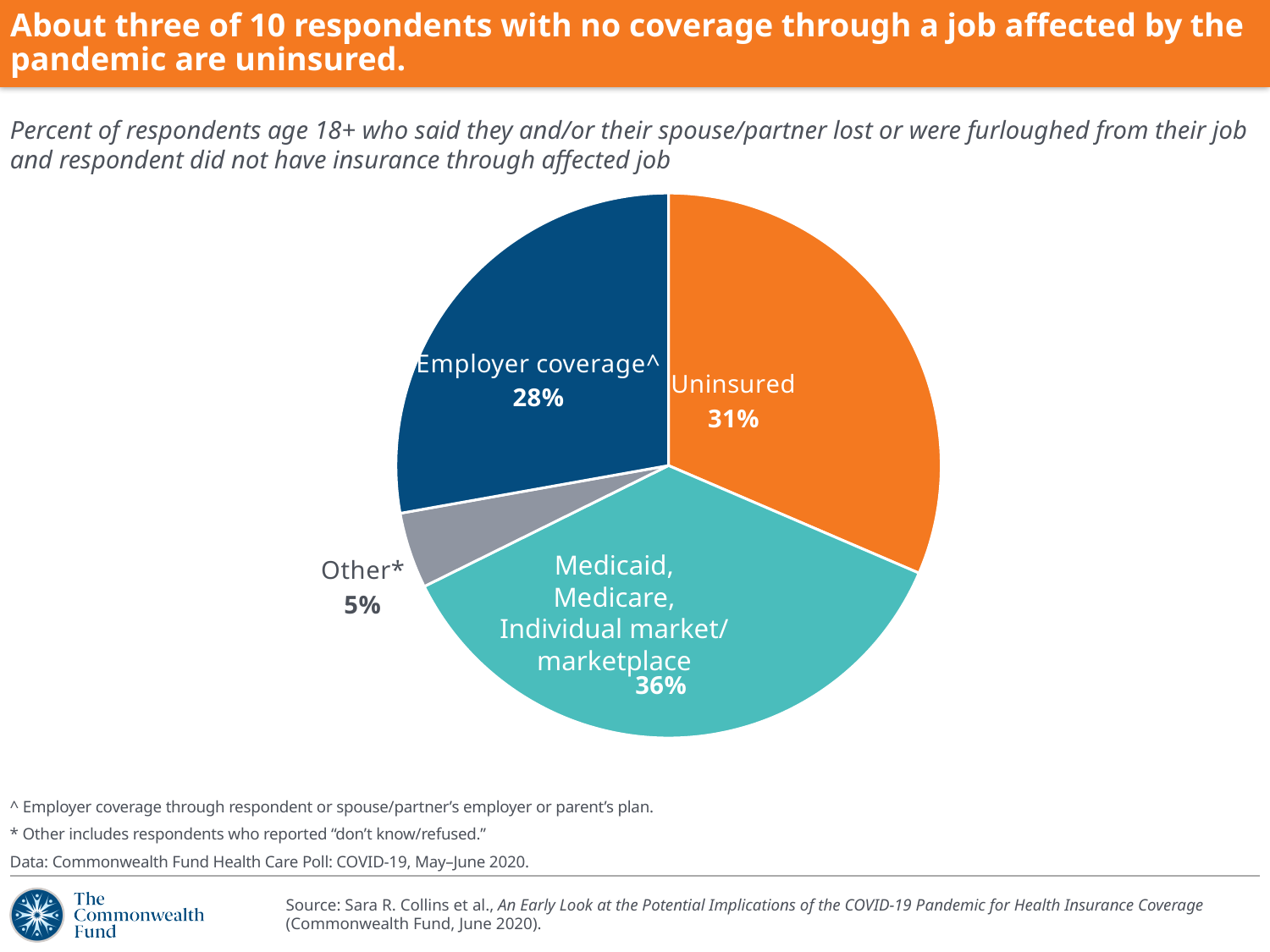
Which is larger: the Uninsured slice or the Employer coverage slice? Uninsured What is the combined share of the Uninsured and Other slices? 36% What kind of chart is shown on the slide? pie chart What percentage of respondents are uninsured? 31% Which category has the largest share of the pie? Medicaid, Medicare, Individual market/marketplace What percentage of respondents fall into the Other category? 5% What percentage of respondents have Medicaid, Medicare, or individual market/marketplace coverage? 36% What is the difference in percentage points between the Uninsured slice and the Employer coverage slice? 3 percentage points Which category has the smallest share of the pie? Other* How many slices does the pie chart have? 4 What percentage of respondents have employer coverage? 28% What colour is the Uninsured slice? orange